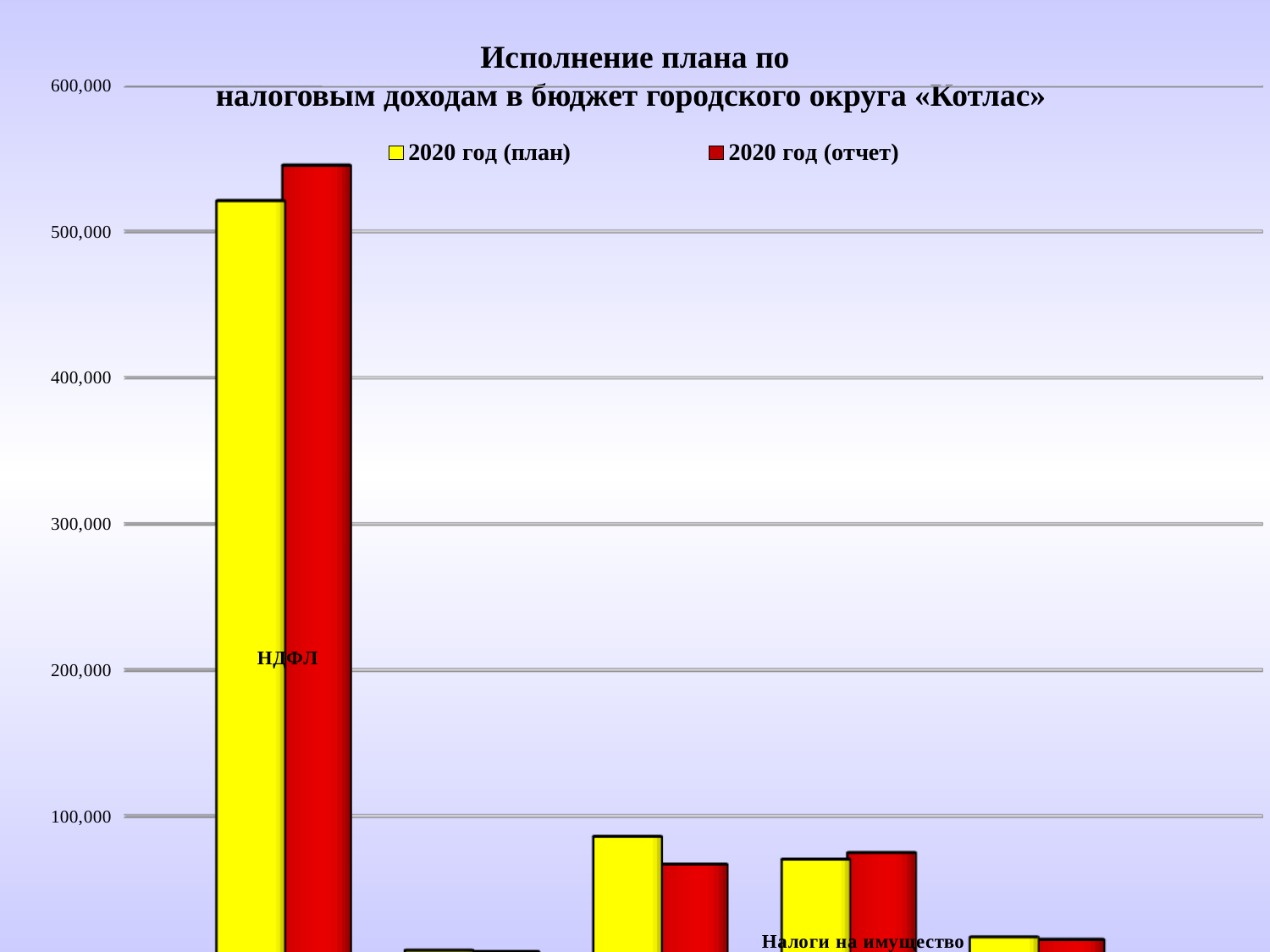
Is the 2020 год (план) value for Налоги на имущество greater or less than 100,000? less Is the 2020 год (отчет) value for НДФЛ greater or less than 600,000? less Which category has the highest values in the chart? НДФЛ What kind of chart is shown on the slide? bar chart What are the two series named in the legend? 2020 год (план) and 2020 год (отчет) Is the 2020 год (план) value for НДФЛ greater or less than 500,000? greater How many series does the legend list? 2 How many groups of bars (categories) are plotted in the chart? 5 Which colour represents the series 2020 год (отчет)? red For НДФЛ, which is larger: the 2020 год (план) value or the 2020 год (отчет) value? 2020 год (отчет)